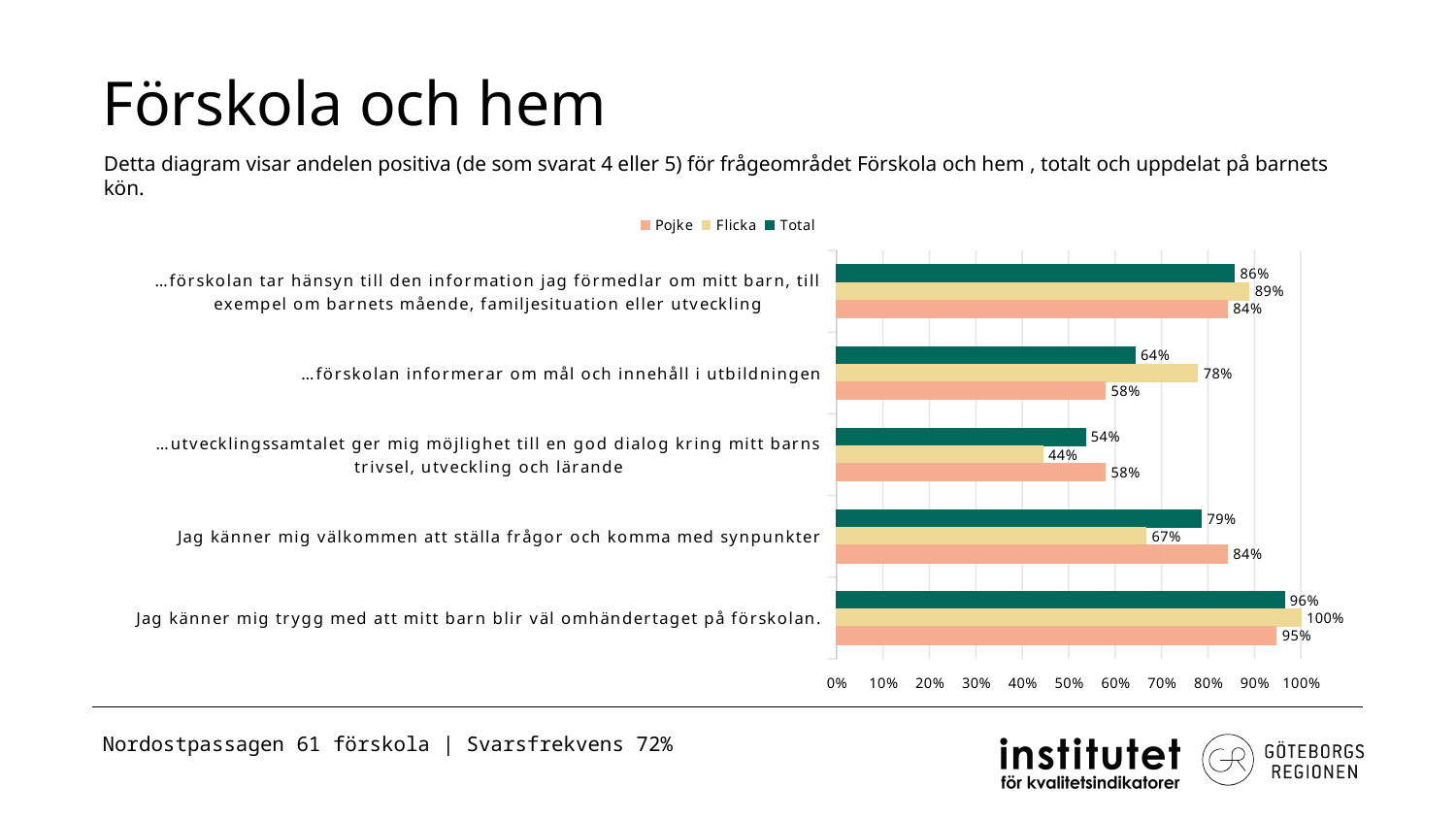
What is the Pojke value for "Jag känner mig välkommen att ställa frågor och komma med synpunkter"? 84% What is the Total value for "Jag känner mig trygg med att mitt barn blir väl omhändertaget på förskolan."? 96% What is the difference between the Flicka and Pojke values for "…förskolan informerar om mål och innehåll i utbildningen"? 20 percentage points Which category has the lowest Total value? …utvecklingssamtalet ger mig möjlighet till en god dialog kring mitt barns trivsel, utveckling och lärande How many series does the legend list? 3 Is the Flicka value for "…utvecklingssamtalet ger mig möjlighet till en god dialog kring mitt barns trivsel, utveckling och lärande" greater or less than 50%? less Which series is shown in green in the legend? Total Which category has the highest Flicka value? Jag känner mig trygg med att mitt barn blir väl omhändertaget på förskolan. For "…utvecklingssamtalet ger mig möjlighet till en god dialog kring mitt barns trivsel, utveckling och lärande", which is larger, the Pojke value or the Flicka value? Pojke What is the Flicka value for "…förskolan informerar om mål och innehåll i utbildningen"? 78% What kind of chart is shown on the slide? Bar chart How many categories (statements) are shown in the chart? 5